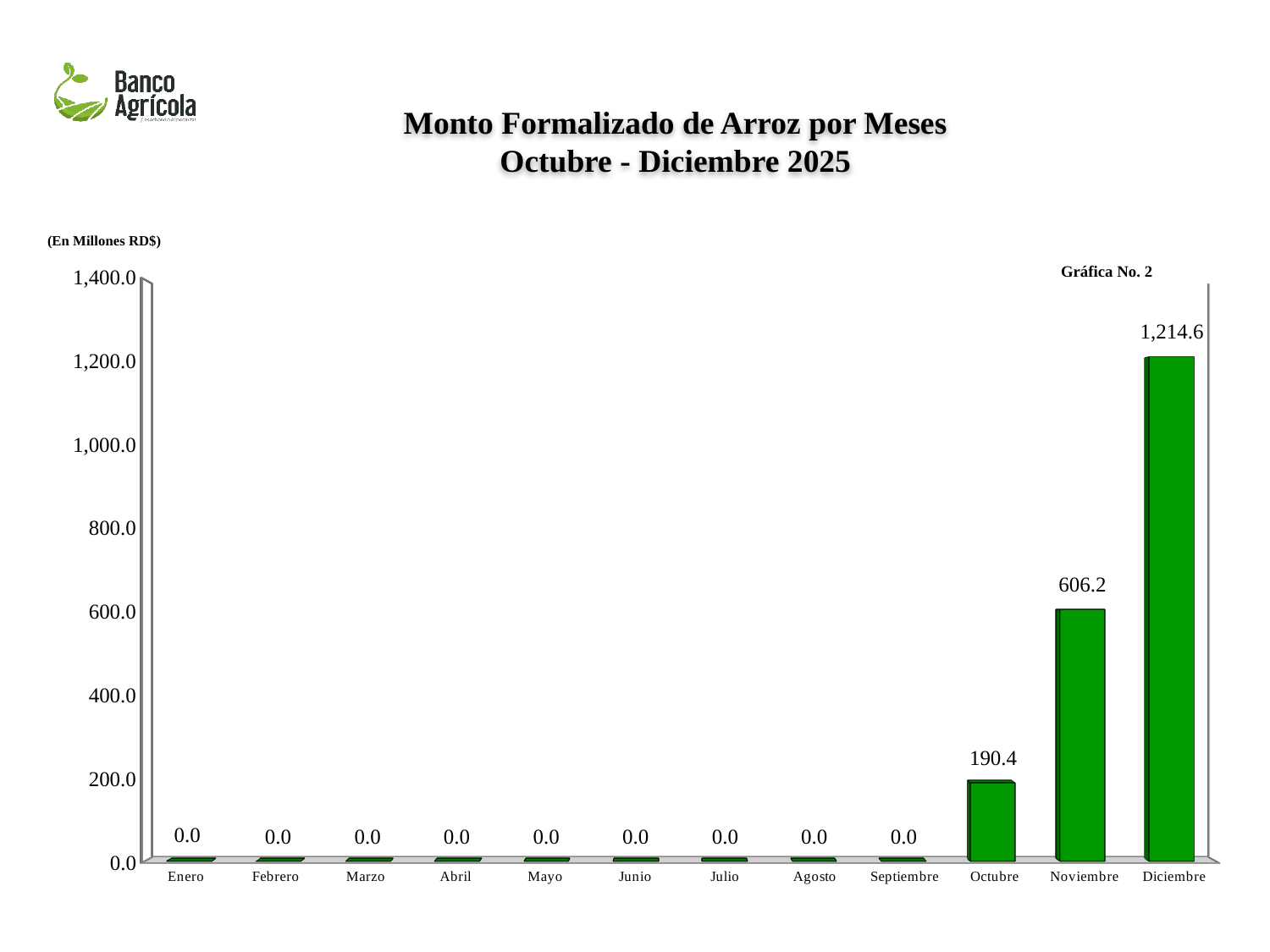
What unit is stated for the values in the chart? En Millones RD$ What is the difference between the values for Noviembre and Octubre? 415.8 What is the value for Septiembre? 0.0 What is the value for Noviembre? 606.2 What kind of chart is shown on the slide? bar chart Which month has the highest value? Diciembre What is the difference between the values for Diciembre and Noviembre? 608.4 What is the value for Diciembre? 1,214.6 What is the value for Octubre? 190.4 Which is larger, the value for Octubre or the value for Noviembre? Noviembre Is the value for Diciembre greater or less than 1,000.0? greater How many months are shown on the x axis? 12